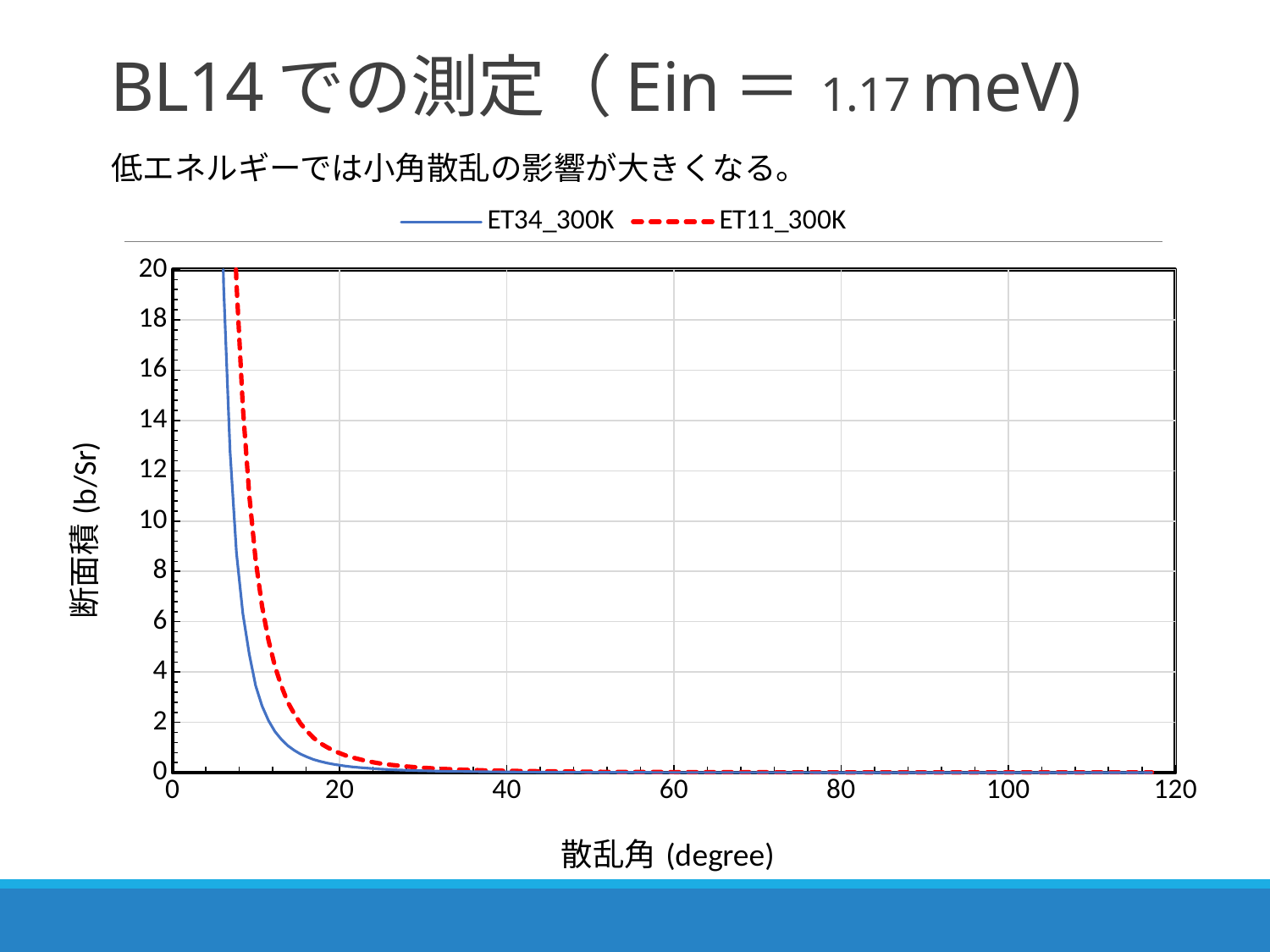
Is the value of ET34_300K at a scattering angle of 20 degrees greater or less than 2? less Is the value of ET11_300K at a scattering angle of 40 degrees greater or less than 2? less What is the maximum value shown on the y axis? 20 What is the title of the x axis? 散乱角 (degree) How many series does the legend list? 2 Do the values of ET11_300K rise or fall as the scattering angle increases? fall Do the values of ET34_300K rise or fall as the scattering angle increases? fall Is the value of ET34_300K at a scattering angle of 60 degrees greater or less than 2? less At a scattering angle of 10 degrees, which series has the larger value, ET34_300K or ET11_300K? ET11_300K What kind of chart is shown on the slide? line chart Which series is drawn as a red dashed line? ET11_300K